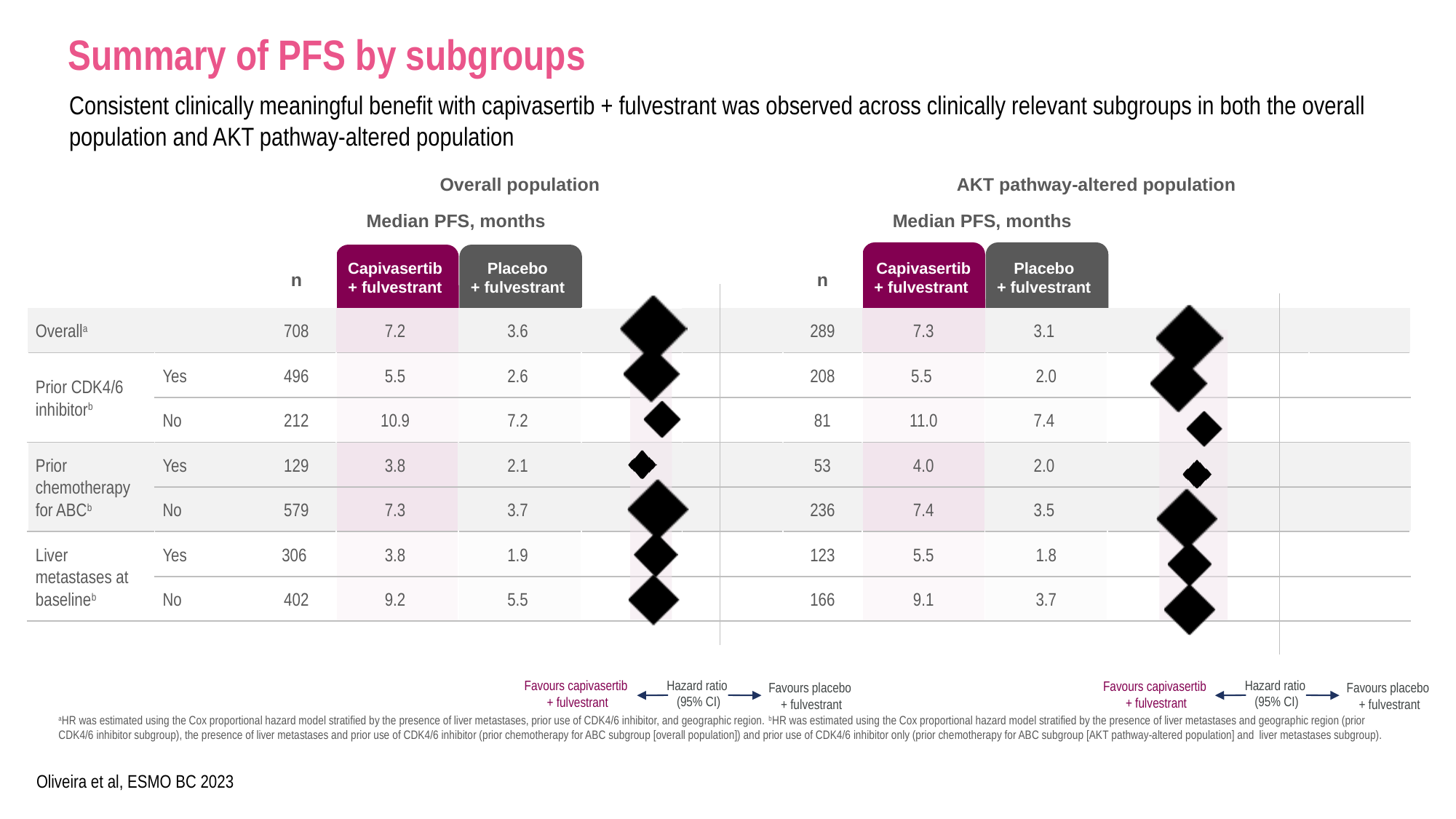
In the Overall population chart, what is the median PFS in months for placebo + fulvestrant in the Overall row? 3.6 In the Overall population chart, what is the difference in median PFS between capivasertib + fulvestrant and placebo + fulvestrant in the Overall row? 3.6 How many subgroup rows are plotted in the Overall population chart? 7 In the Overall population chart, what is the median PFS in months for capivasertib + fulvestrant in the Overall row? 7.2 In the AKT pathway-altered population chart, for the Liver metastases at baseline Yes subgroup, which arm has the larger median PFS? Capivasertib + fulvestrant In the AKT pathway-altered population chart, which subgroup has the lowest median PFS for capivasertib + fulvestrant? Prior chemotherapy for ABC: Yes In the AKT pathway-altered population chart, what is the n for the Overall row? 289 In the AKT pathway-altered population chart, what is the median PFS for capivasertib + fulvestrant in the Prior CDK4/6 inhibitor No subgroup? 11.0 In the AKT pathway-altered population chart, what is the difference in median PFS between capivasertib + fulvestrant and placebo + fulvestrant in the Overall row? 4.2 In the Overall population chart, which subgroup has the highest median PFS for capivasertib + fulvestrant? Prior CDK4/6 inhibitor: No What kind of chart is used to display the hazard ratios on this slide? Forest plot In the Overall population chart, which treatment does the left side of the hazard ratio axis favour? Capivasertib + fulvestrant